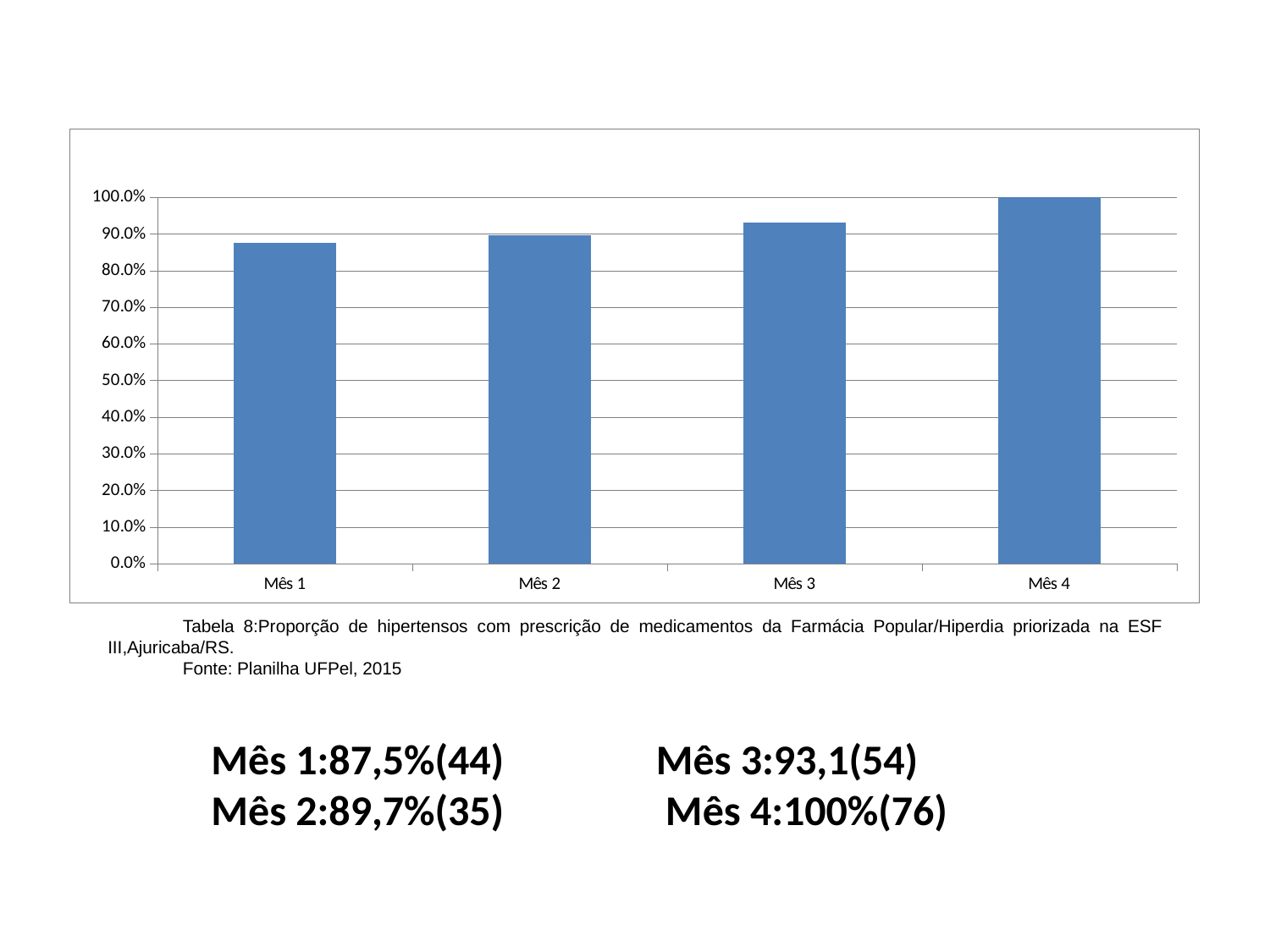
What is the value for Mês 4? 100% What is the difference between the values for Mês 4 and Mês 1? 12,5% Which month has the highest value in the chart? Mês 4 What type of chart is shown on the slide? bar chart Do the values rise or fall from Mês 1 to Mês 4? rise Is the value for Mês 1 greater or less than 90.0%? less Which is larger, the value for Mês 2 or the value for Mês 4? Mês 4 How many bars (categories) does the chart show? 4 Which month has the lowest value in the chart? Mês 1 What is the value for Mês 2? 89,7% Is the value for Mês 3 greater or less than 90.0%? greater What is the value for Mês 1? 87,5%